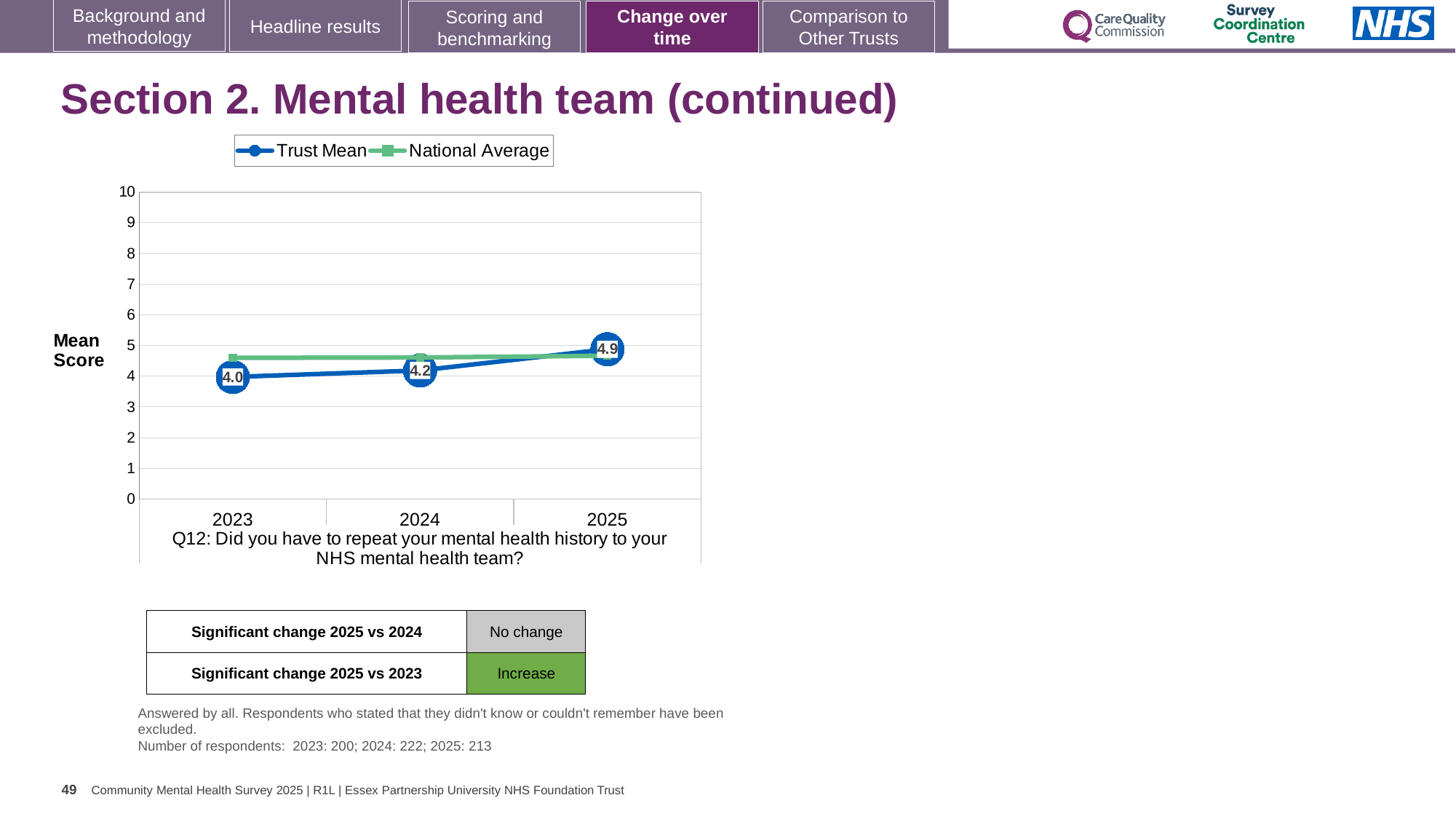
What is the Trust Mean score for 2024? 4.2 Is the National Average value for 2024 greater or less than 4? greater In 2023, which is larger: the Trust Mean or the National Average? National Average What is the Trust Mean score for 2023? 4.0 How many series does the chart legend list? 2 Does the Trust Mean score rise or fall from 2023 to 2025? rise What is the Trust Mean score for 2025? 4.9 In which year is the Trust Mean score lowest? 2023 In which year is the Trust Mean score highest? 2025 What is the difference between the Trust Mean score in 2025 and in 2023? 0.9 What kind of chart is shown on the slide? line chart How many years are shown on the x axis of the chart? 3